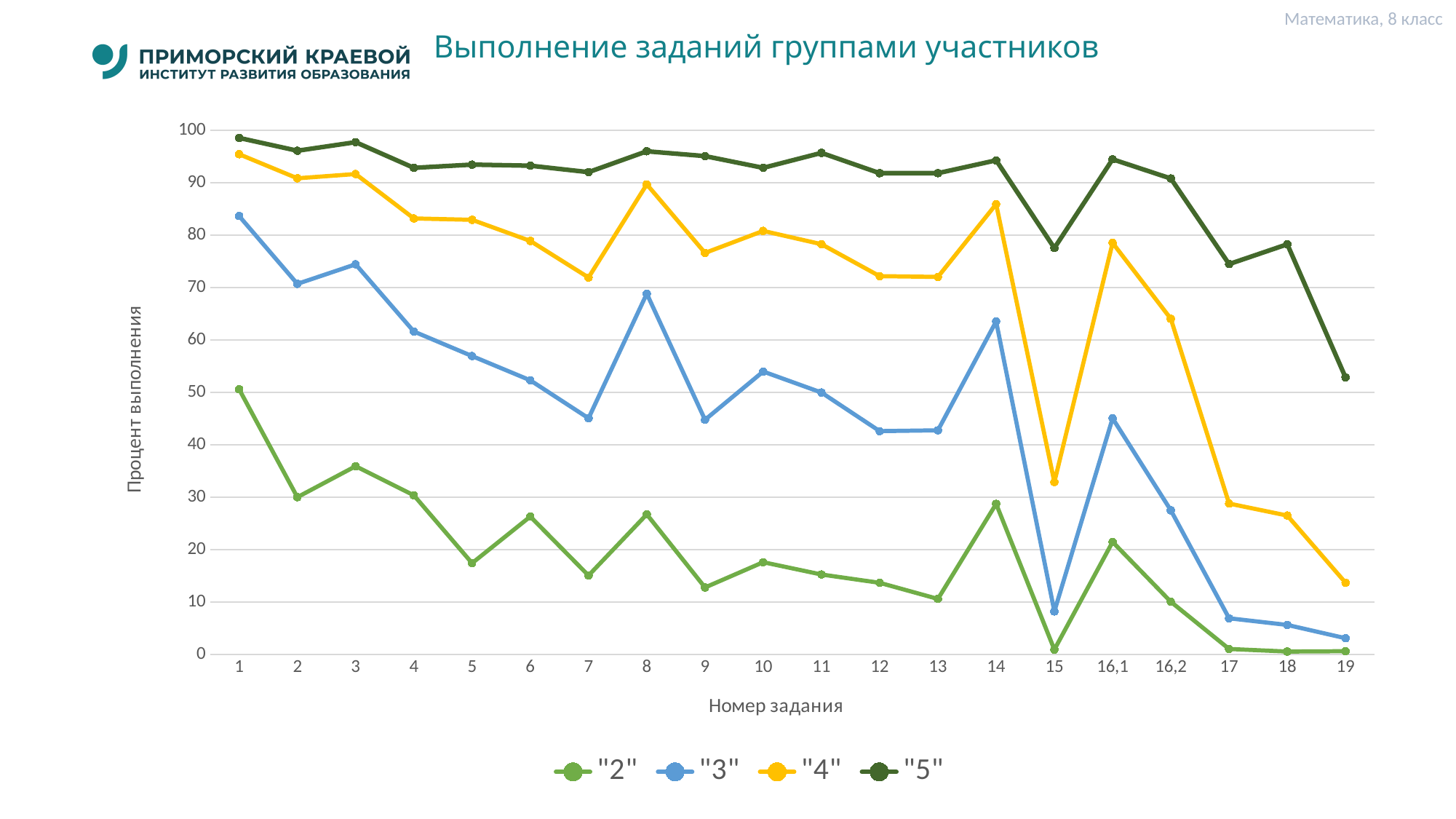
For series "3", which is larger: the value at task 7 or at task 8? task 8 What is the label of the y axis? Процент выполнения For series "4", at which task number is the value lowest? 19 Is the value for series "3" at task 15 greater or less than 20? less How many task numbers are shown along the x axis? 20 Do the values for series "5" rise or fall from task 16,1 to task 19? fall How many series does the legend list? 4 Is the value for series "4" at task 15 greater or less than 40? less Is the value for series "2" at task 1 greater or less than 40? greater What kind of chart is shown on the slide? line chart For series "2", at which task number is the value highest? 1